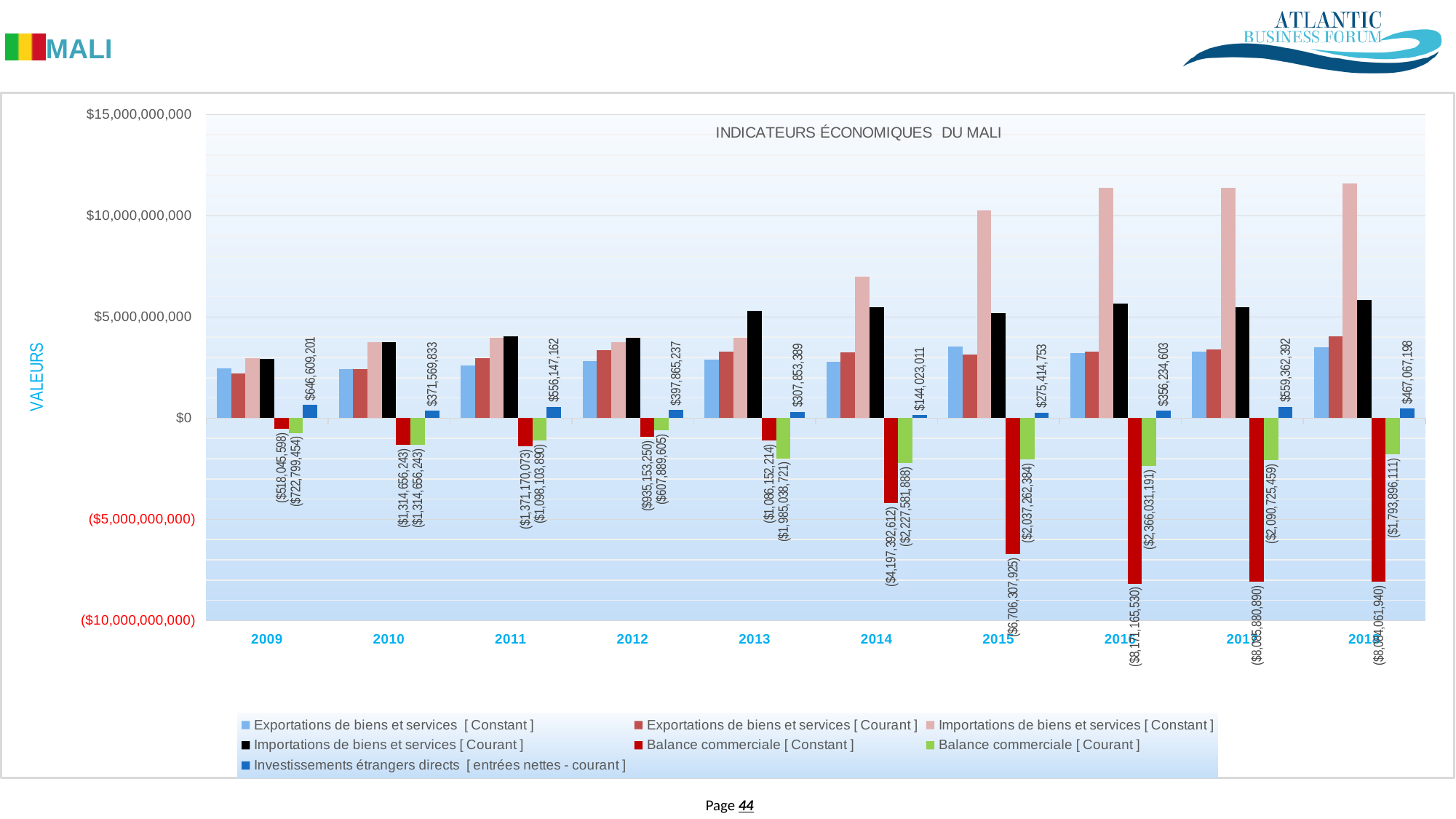
Which year has the larger value of Investissements étrangers directs, 2011 or 2012? 2011 What is the title of the chart? INDICATEURS ÉCONOMIQUES DU MALI In which year is Investissements étrangers directs [entrées nettes - courant] highest? 2009 What kind of chart is shown on the slide? bar chart What is the value of Balance commerciale [Constant] in 2015? ($6,706,307,925) How many series does the chart legend list? 7 What is the value of Balance commerciale [Courant] in 2013? ($1,985,038,721) What is the value of Investissements étrangers directs [entrées nettes - courant] in 2009? $646,609,201 What is the difference between Investissements étrangers directs in 2009 and in 2010? $275,039,368 How many years are shown on the x axis of the chart? 10 In which year is Investissements étrangers directs [entrées nettes - courant] lowest? 2014 Is the value of Importations de biens et services [Constant] in 2018 greater or less than $10,000,000,000? greater